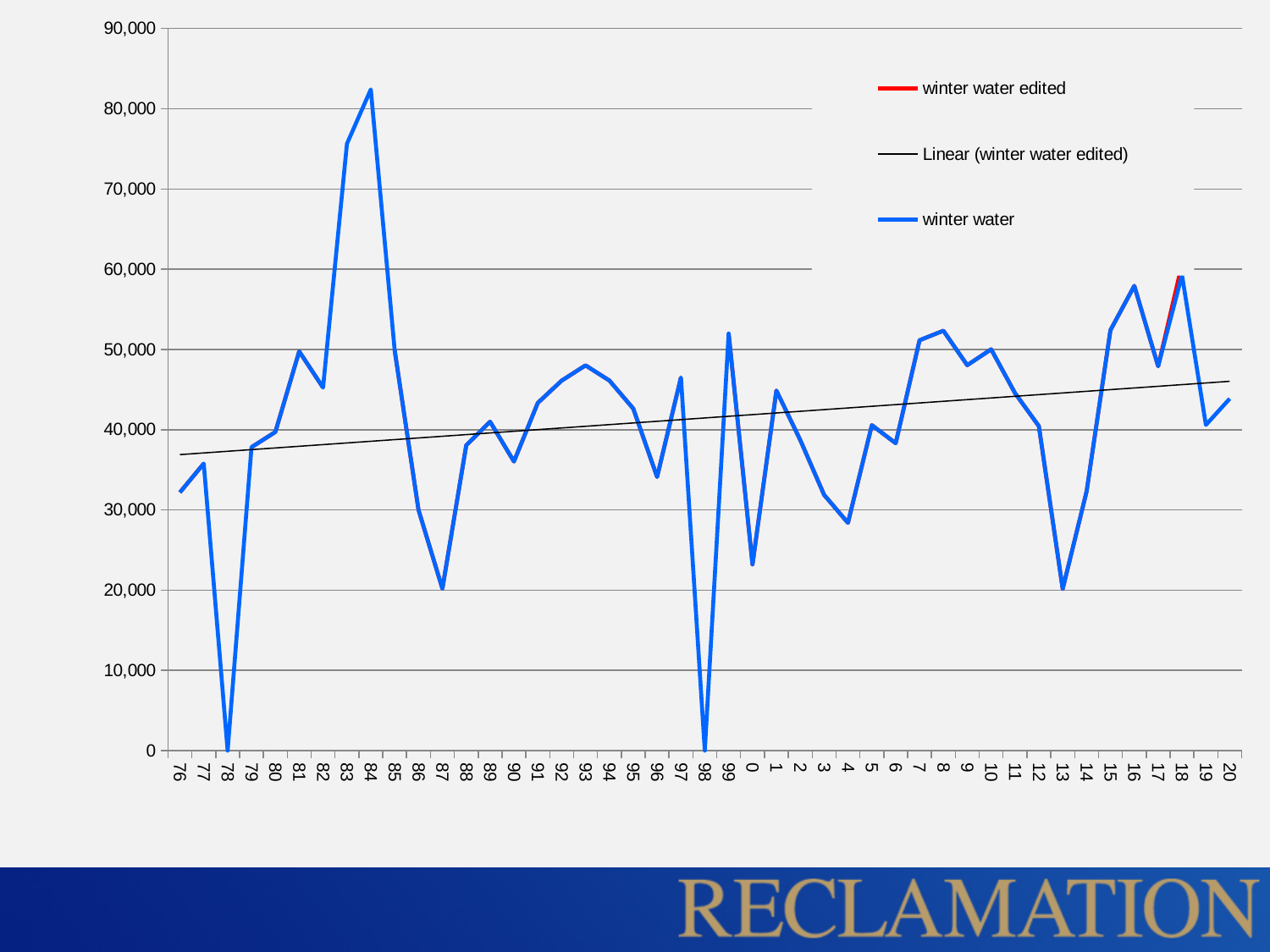
Is the winter water value for 86 greater or less than 40,000? less Does the linear trend line rise or fall from left to right across the years? rises Is the winter water value for 87 greater or less than 30,000? less How many series does the legend list? 3 Which year has the highest winter water value? 84 Is the winter water value for 16 greater or less than 50,000? greater What kind of chart is shown on the slide? line chart Which is larger, the winter water value for 87 or for 88? 88 What colour is the 'winter water' line in the legend? blue How many year labels are shown along the x axis? 45